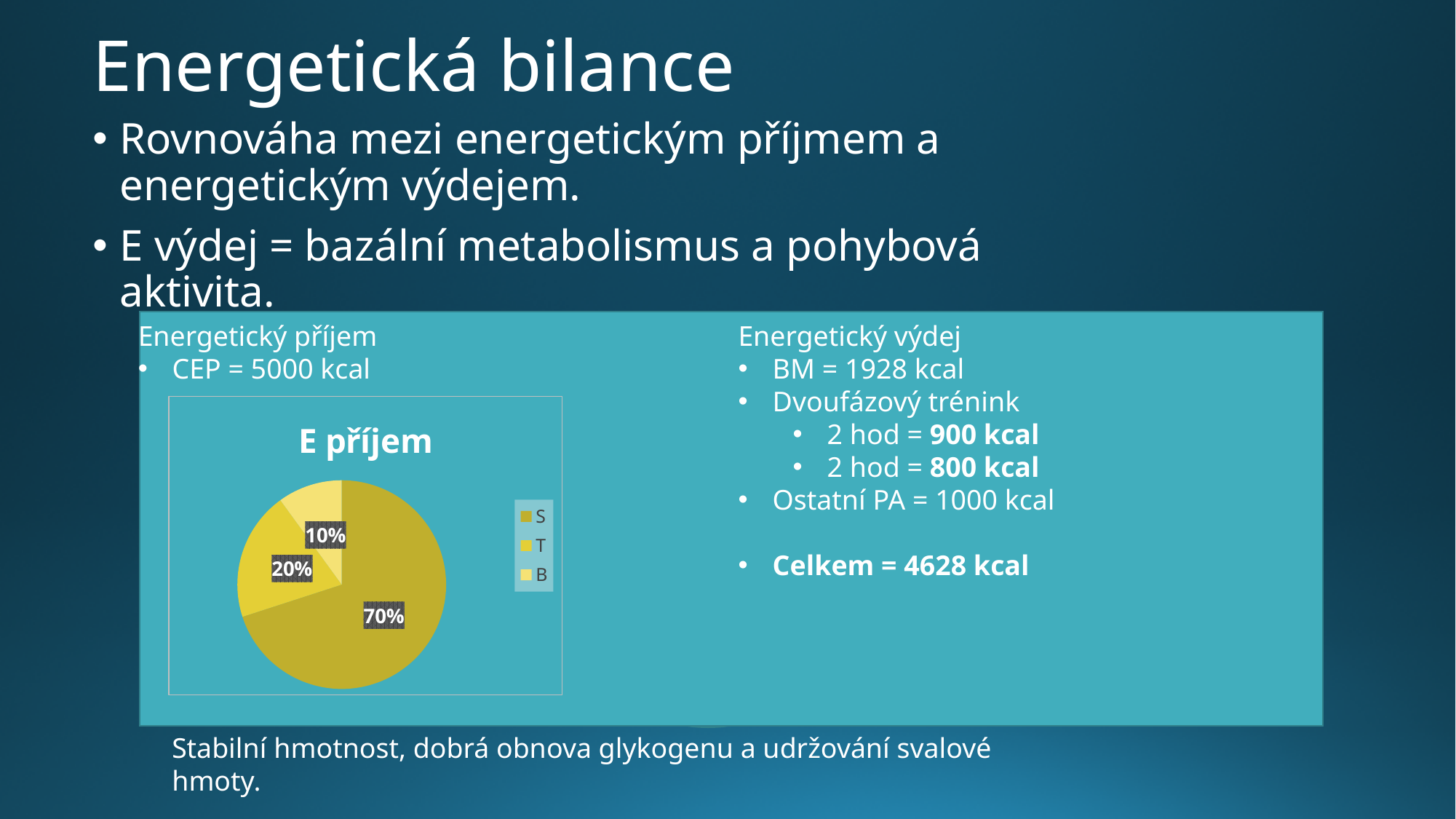
Which category has the largest slice of the pie? S What share of the pie does T take? 20% How many slices does the pie chart have? 3 How many entries does the legend list? 3 What are the legend entries of the chart, in order? S, T, B What kind of chart is shown on the slide? pie chart Which slice is larger, T or B? T What is the title of the chart? E příjem What share of the pie does B take? 10% What share of the pie does S take? 70% Which category has the smallest slice of the pie? B What is the difference in percentage points between the S slice and the T slice? 50